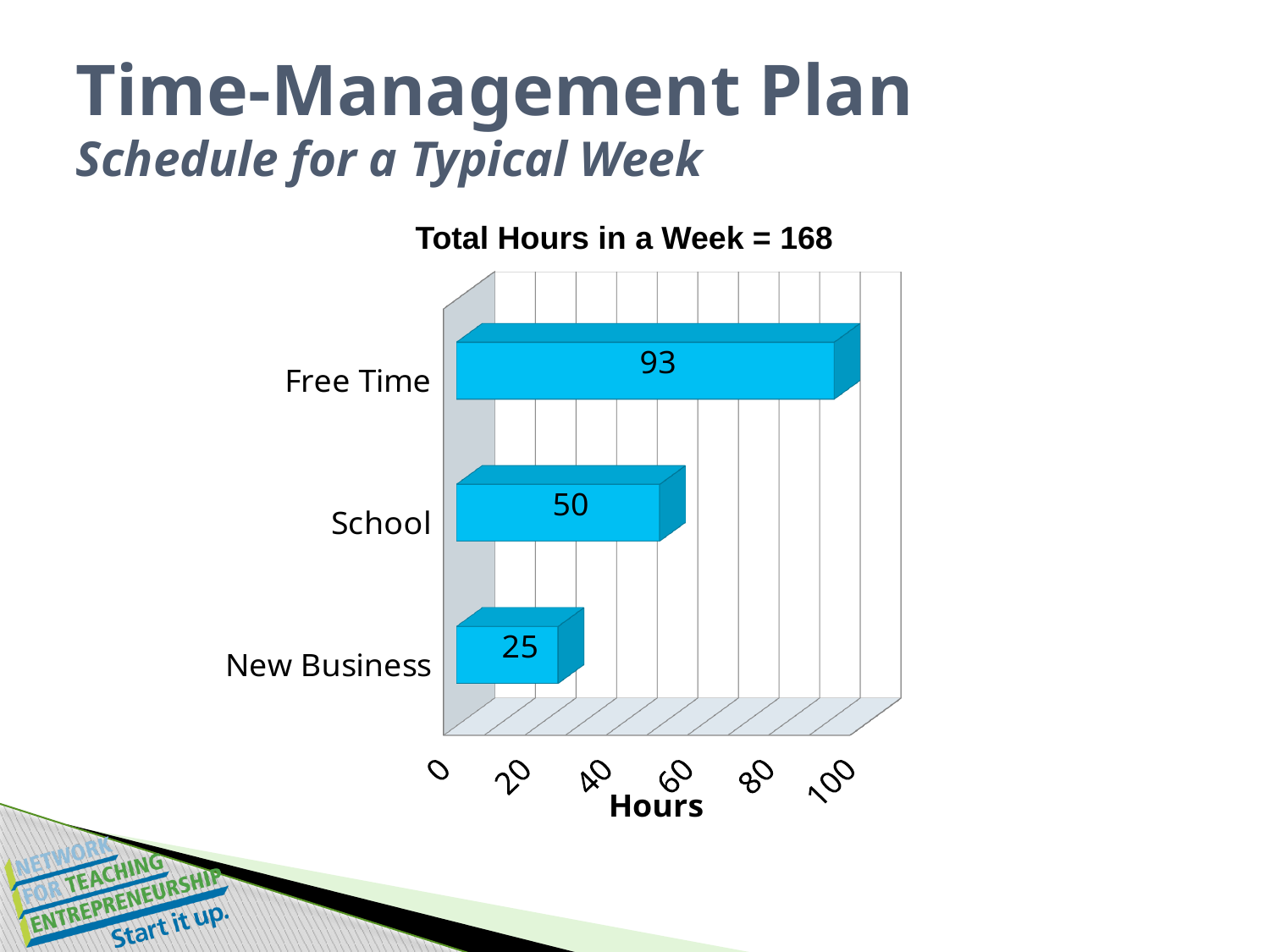
How many categories are shown in the chart? 3 How many hours are shown for School? 50 How many hours are shown for New Business? 25 Is the value for Free Time greater or less than 80? greater Which has more hours, School or New Business? School What kind of chart is shown on the slide? Bar chart Which category has the highest number of hours? Free Time What is the difference in hours between School and New Business? 25 What is the title of the chart? Total Hours in a Week = 168 What is the difference in hours between Free Time and School? 43 How many hours are shown for Free Time? 93 Which category has the lowest number of hours? New Business